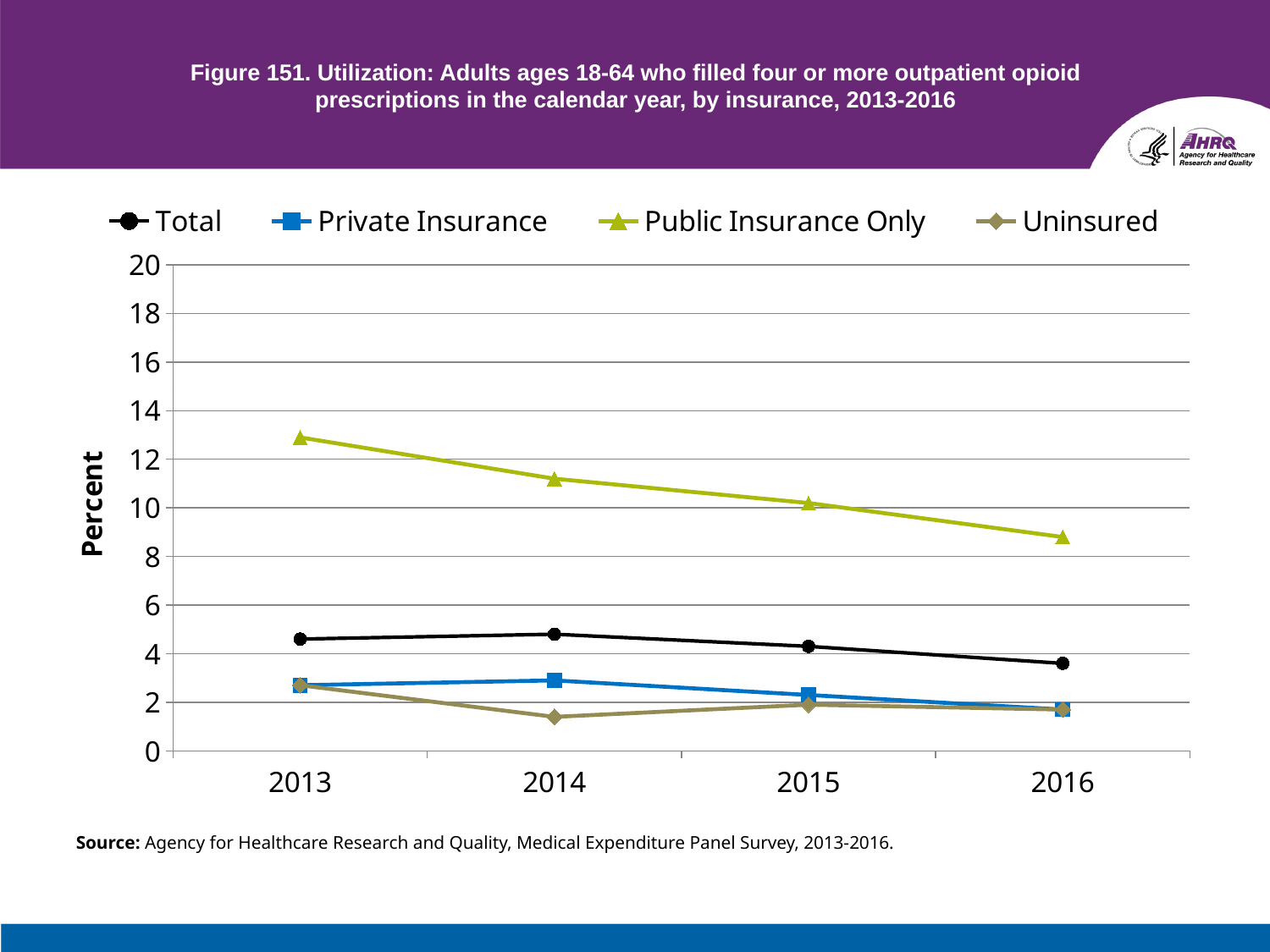
Is the value for Uninsured in 2014 greater or less than 2? less Is the value for Public Insurance Only in 2016 greater or less than 10? less How many series does the legend list? 4 What kind of chart is shown on the slide? line chart Is the value for Public Insurance Only in 2013 greater or less than 12? greater Does the Public Insurance Only series rise or fall from 2013 to 2016? fall Which series has the lowest value in 2014? Uninsured Which series has the highest value in 2013? Public Insurance Only How many years are plotted along the x axis? 4 In 2015, which is larger: the value for Total or the value for Private Insurance? Total What is the label on the y axis? Percent